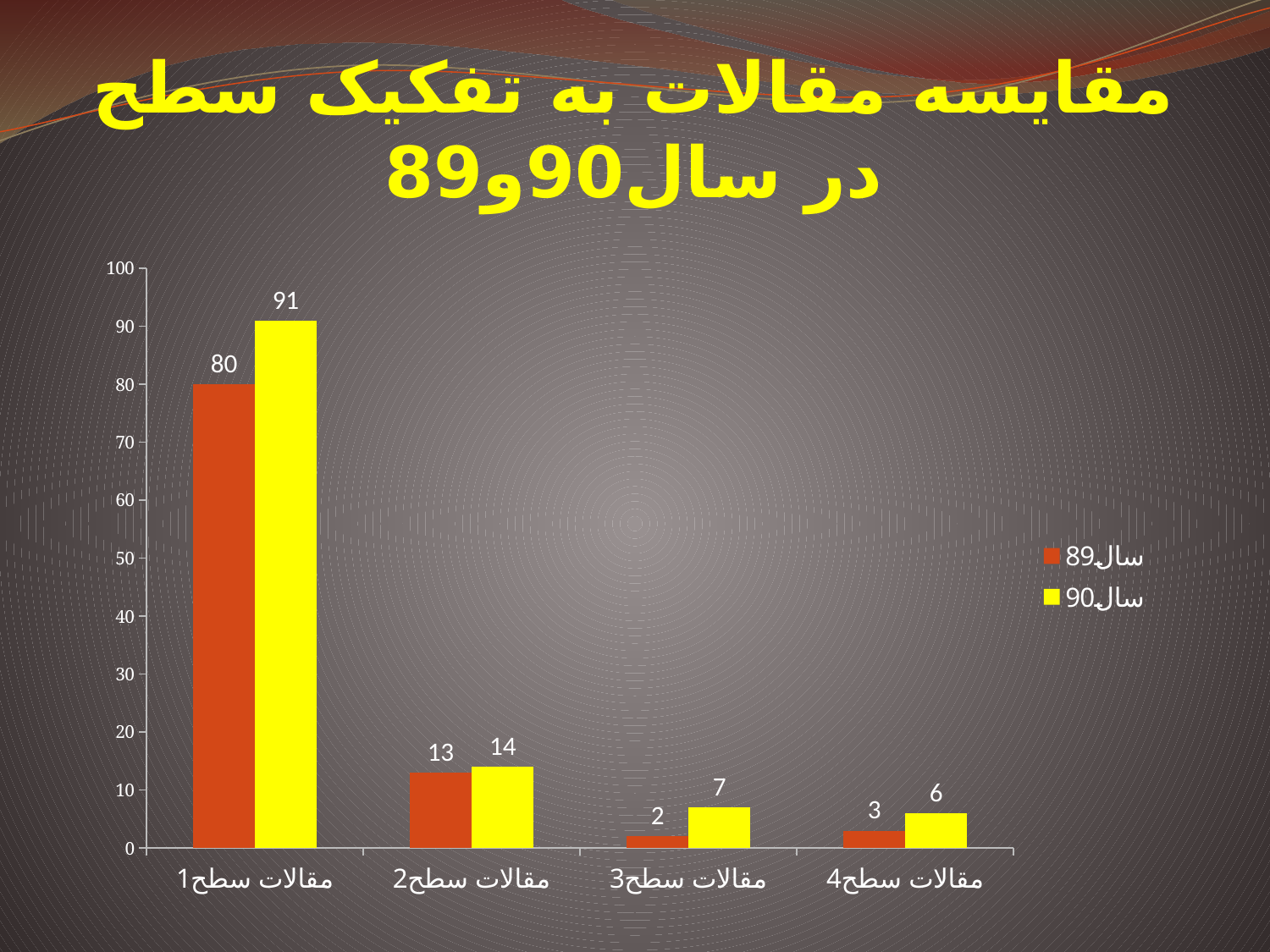
Which colour represents the سال90 series? yellow Which category has the highest value in the سال90 series? مقالات سطح1 How many categories are shown on the x axis? 4 Which is larger for مقالات سطح3: the سال89 value or the سال90 value? سال90 What is the value for مقالات سطح3 in the سال90 series? 7 What kind of chart is shown on the slide? bar chart How many series does the legend list? 2 What is the value for مقالات سطح1 in the سال90 series? 91 Which category has the lowest value in the سال89 series? مقالات سطح3 What is the value for مقالات سطح4 in the سال89 series? 3 What is the value for مقالات سطح1 in the سال89 series? 80 What is the difference between the سال90 and سال89 values for مقالات سطح1? 11